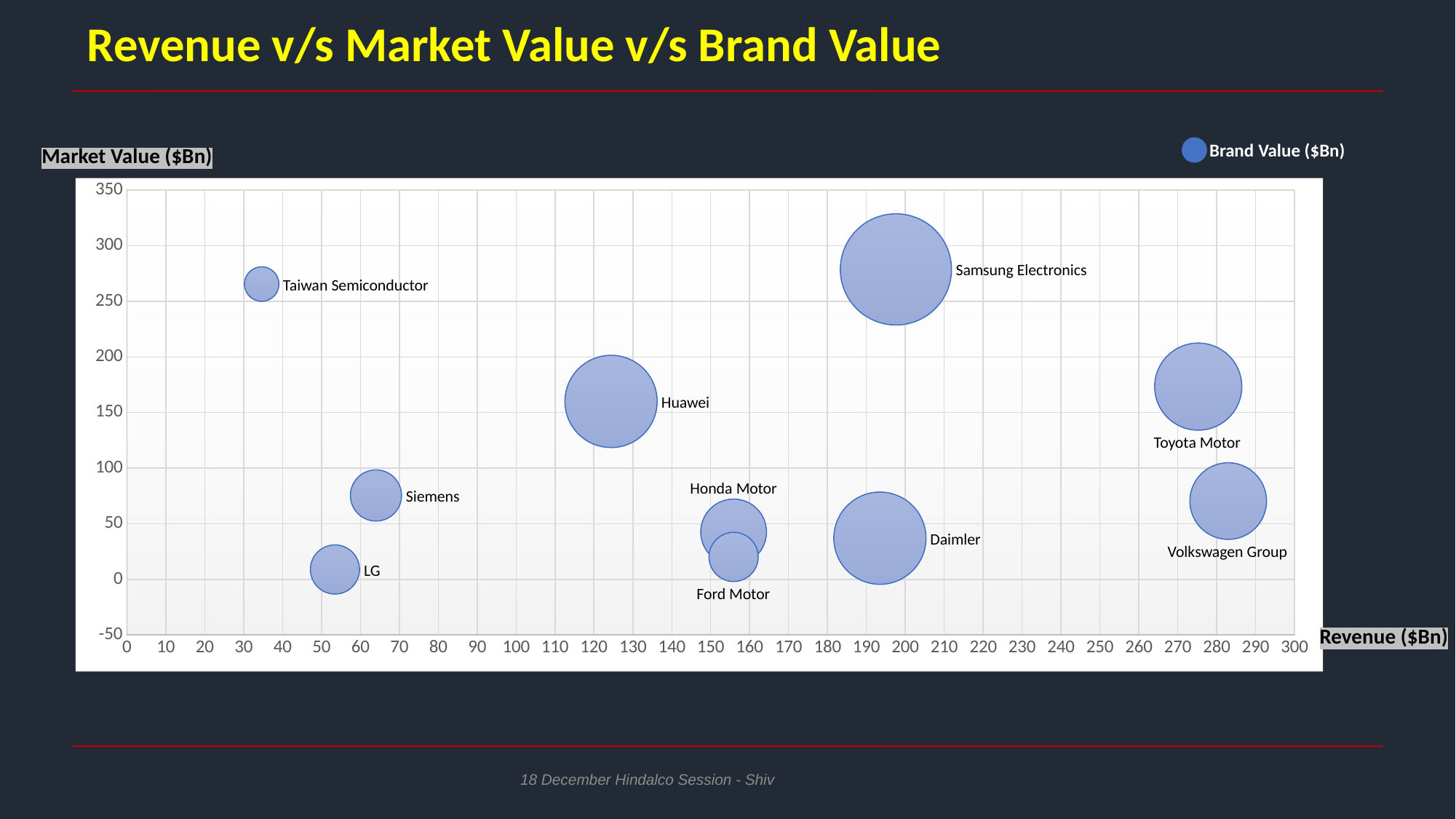
Is the market value for Siemens greater or less than 100? less What does the legend say the bubble size represents? Brand Value ($Bn) Which has the higher market value, Huawei or Siemens? Huawei What is the title of the chart? Revenue v/s Market Value v/s Brand Value How many companies are plotted as bubbles on the chart? 10 How many series does the legend list? 1 Which company has the largest bubble (brand value)? Samsung Electronics What kind of chart is shown on the slide? Bubble chart Is the market value for Huawei greater or less than 100? greater Which company has the lowest revenue on the chart? Taiwan Semiconductor Which has the higher revenue, Samsung Electronics or LG? Samsung Electronics Is the revenue for Samsung Electronics greater or less than 150? greater